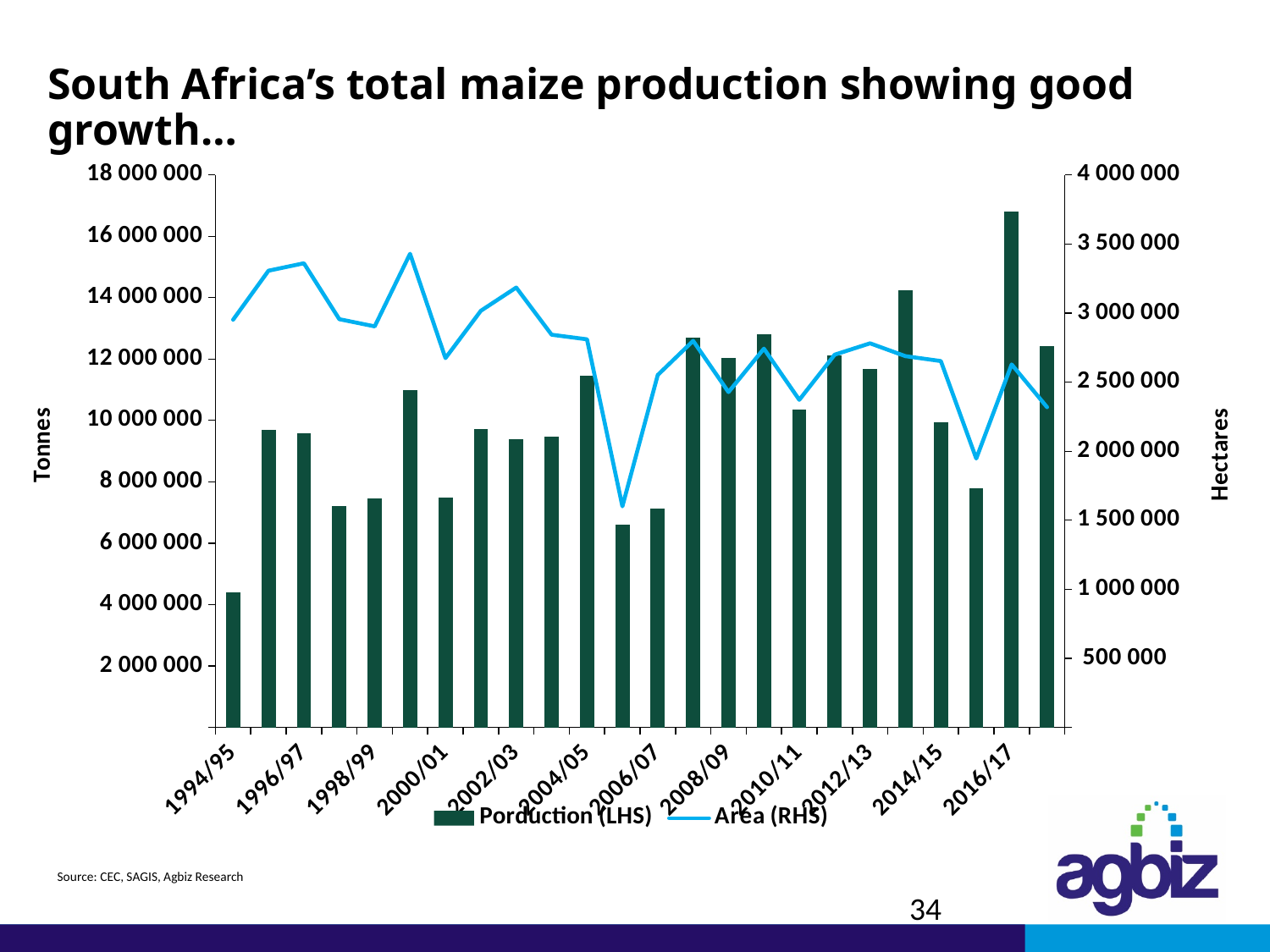
Does the Area (RHS) line end higher or lower in 2016/17 than it started in 1994/95? lower What kind of chart is shown on the slide? A combined bar and line chart Is the production value for 2016/17 greater or less than 16 000 000 tonnes? greater Is the Area (RHS) value for 2006/07 greater or less than 2 000 000 hectares? greater Which year has the lowest maize production (bar)? 1994/95 Is the Area (RHS) value for 1994/95 greater or less than 2 500 000 hectares? greater How many series does the legend list? 2 Which year has higher maize production, 1996/97 or 2006/07? 1996/97 What is the label on the left vertical axis? Tonnes Which year has the highest maize production (bar)? 2016/17